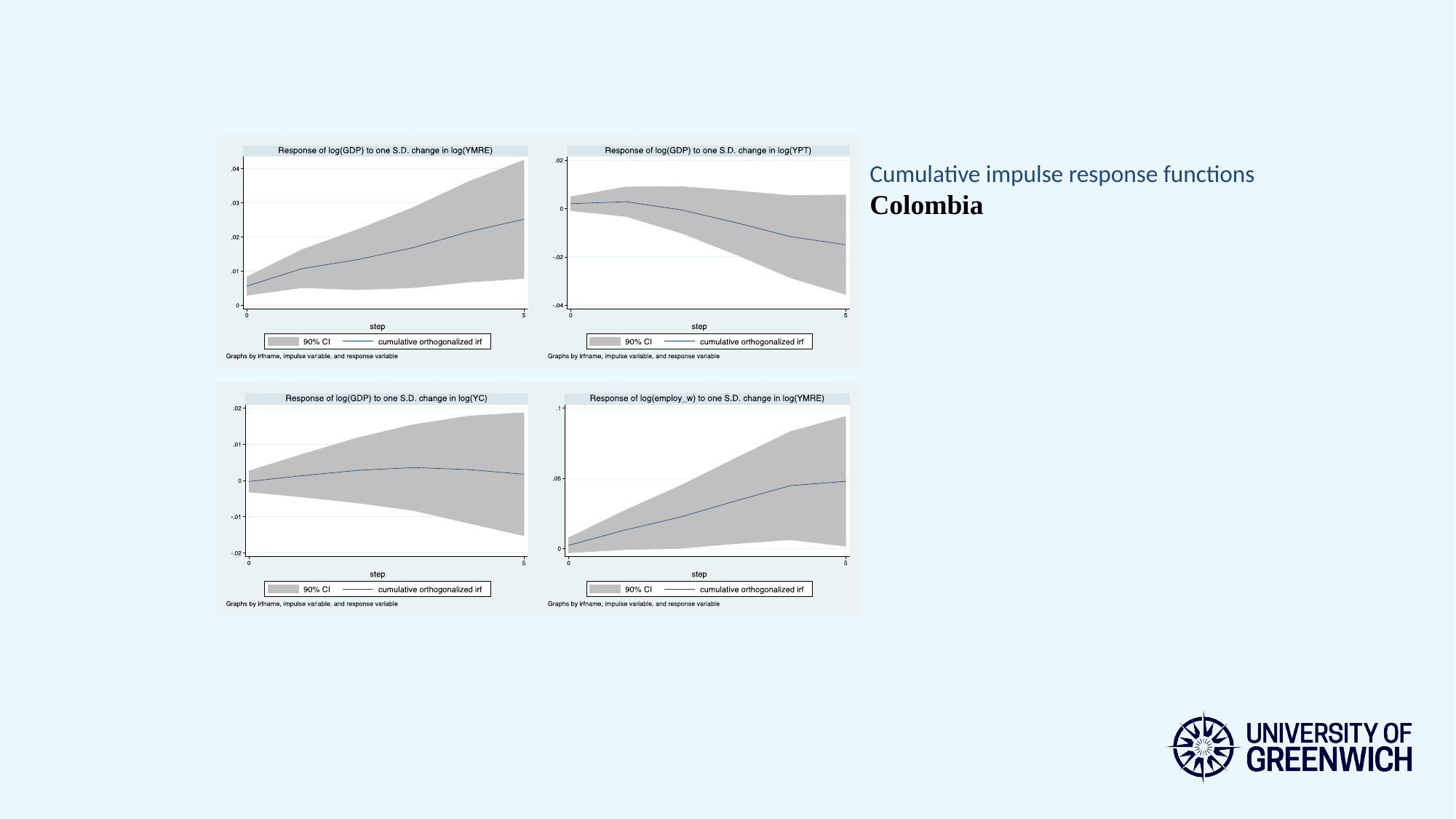
In the top-right chart, 'Response of log(GDP) to one S.D. change in log(YPT)', is the value of the cumulative orthogonalized irf at step 5 greater or less than 0? less In the top-left chart, 'Response of log(GDP) to one S.D. change in log(YMRE)', does the cumulative orthogonalized irf line rise or fall from step 0 to step 5? rise In the bottom-right chart, 'Response of log(employ_w) to one S.D. change in log(YMRE)', does the cumulative orthogonalized irf line rise or fall from step 0 to step 5? rise How many entries does the legend of the top-left chart, 'Response of log(GDP) to one S.D. change in log(YMRE)', list? 2 What does the grey shaded band in the top-right chart, 'Response of log(GDP) to one S.D. change in log(YPT)', represent according to the legend? 90% CI In the bottom-right chart, 'Response of log(employ_w) to one S.D. change in log(YMRE)', is the value of the cumulative orthogonalized irf at step 5 greater or less than 0? greater What kind of chart is the top-left chart, 'Response of log(GDP) to one S.D. change in log(YMRE)'? line chart How many charts are shown on the slide? 4 What is the x-axis label of the bottom-right chart, 'Response of log(employ_w) to one S.D. change in log(YMRE)'? step In the bottom-left chart, 'Response of log(GDP) to one S.D. change in log(YC)', is the value of the cumulative orthogonalized irf at step 5 greater or less than .01? less In the top-right chart, 'Response of log(GDP) to one S.D. change in log(YPT)', does the cumulative orthogonalized irf line rise or fall from step 0 to step 5? fall